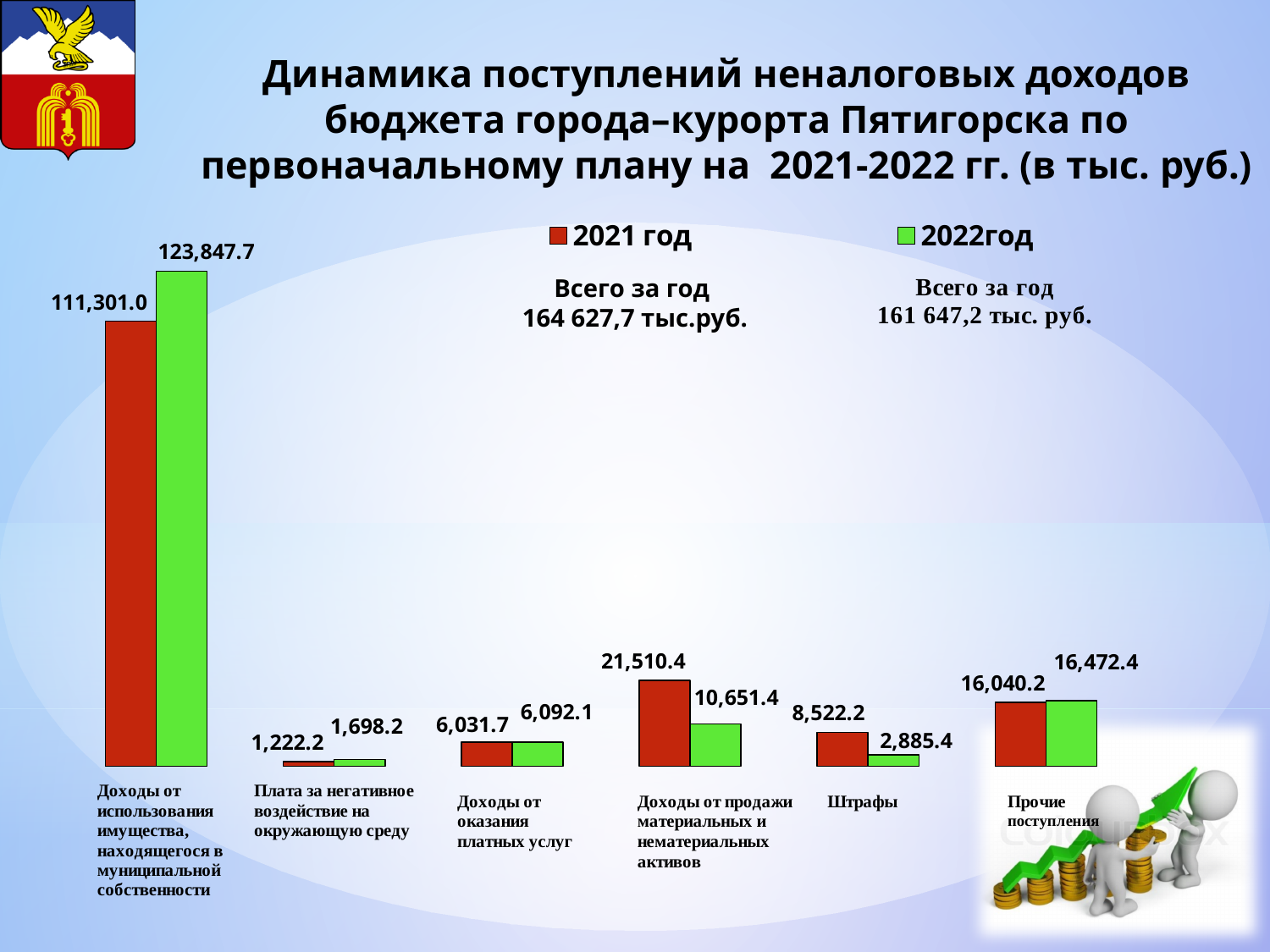
Which category has the highest 2022год value? Доходы от использования имущества, находящегося в муниципальной собственности What is the 2022год value for Доходы от оказания платных услуг? 6,092.1 Which category has the lowest 2021 год value? Плата за негативное воздействие на окружающую среду What is the difference between the 2021 год and 2022год values for Штрафы? 5,636.8 For Доходы от продажи материальных и нематериальных активов, which year has the larger value, 2021 год or 2022год? 2021 год What is the 2021 год value for Штрафы? 8,522.2 How many series does the legend list? 2 What is the 2022год value for Плата за негативное воздействие на окружающую среду? 1,698.2 What kind of chart is shown on the slide? Bar chart What is the difference between the 2022год and 2021 год values for Доходы от использования имущества, находящегося в муниципальной собственности? 12,546.7 What is the 2021 год value for Доходы от продажи материальных и нематериальных активов? 21,510.4 How many categories are shown on the chart? 6